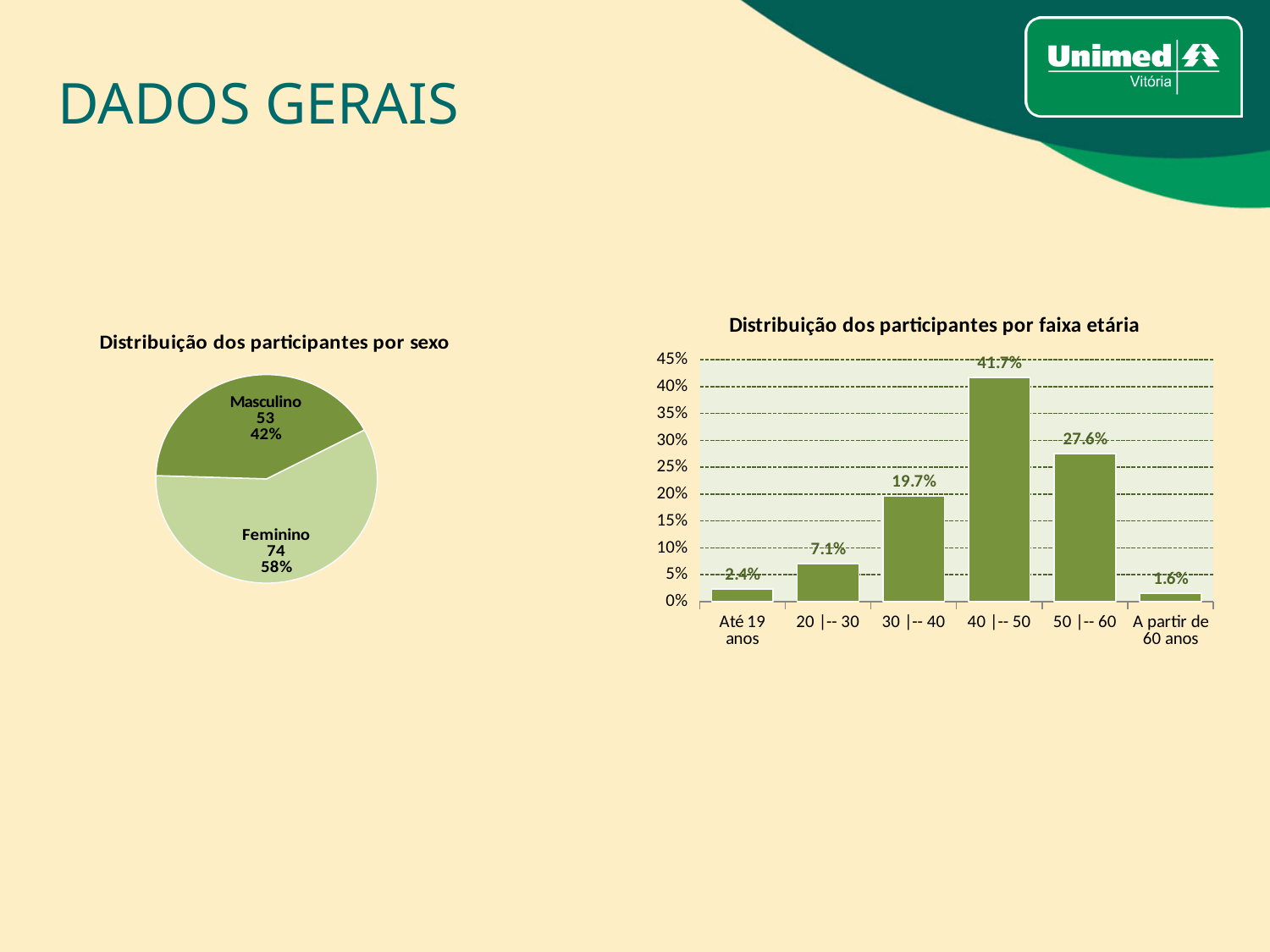
In the chart 'Distribuição dos participantes por faixa etária', what is the value for 40 |-- 50? 41.7% In the chart 'Distribuição dos participantes por faixa etária', which age group has the lowest value? A partir de 60 anos In the chart 'Distribuição dos participantes por faixa etária', what is the difference between the values for 40 |-- 50 and 50 |-- 60? 14.1% In the chart 'Distribuição dos participantes por faixa etária', is the value for 30 |-- 40 larger than the value for 20 |-- 30? Yes In the chart 'Distribuição dos participantes por sexo', what kind of chart is shown? pie chart In the chart 'Distribuição dos participantes por sexo', which category has the larger slice? Feminino In the chart 'Distribuição dos participantes por sexo', what is the difference in participant count between Feminino and Masculino? 21 In the chart 'Distribuição dos participantes por sexo', what share of the pie is Masculino? 42% In the chart 'Distribuição dos participantes por sexo', how many participants are Feminino? 74 In the chart 'Distribuição dos participantes por faixa etária', how many age groups are shown? 6 In the chart 'Distribuição dos participantes por faixa etária', which age group has the highest value? 40 |-- 50 In the chart 'Distribuição dos participantes por faixa etária', what kind of chart is shown? bar chart